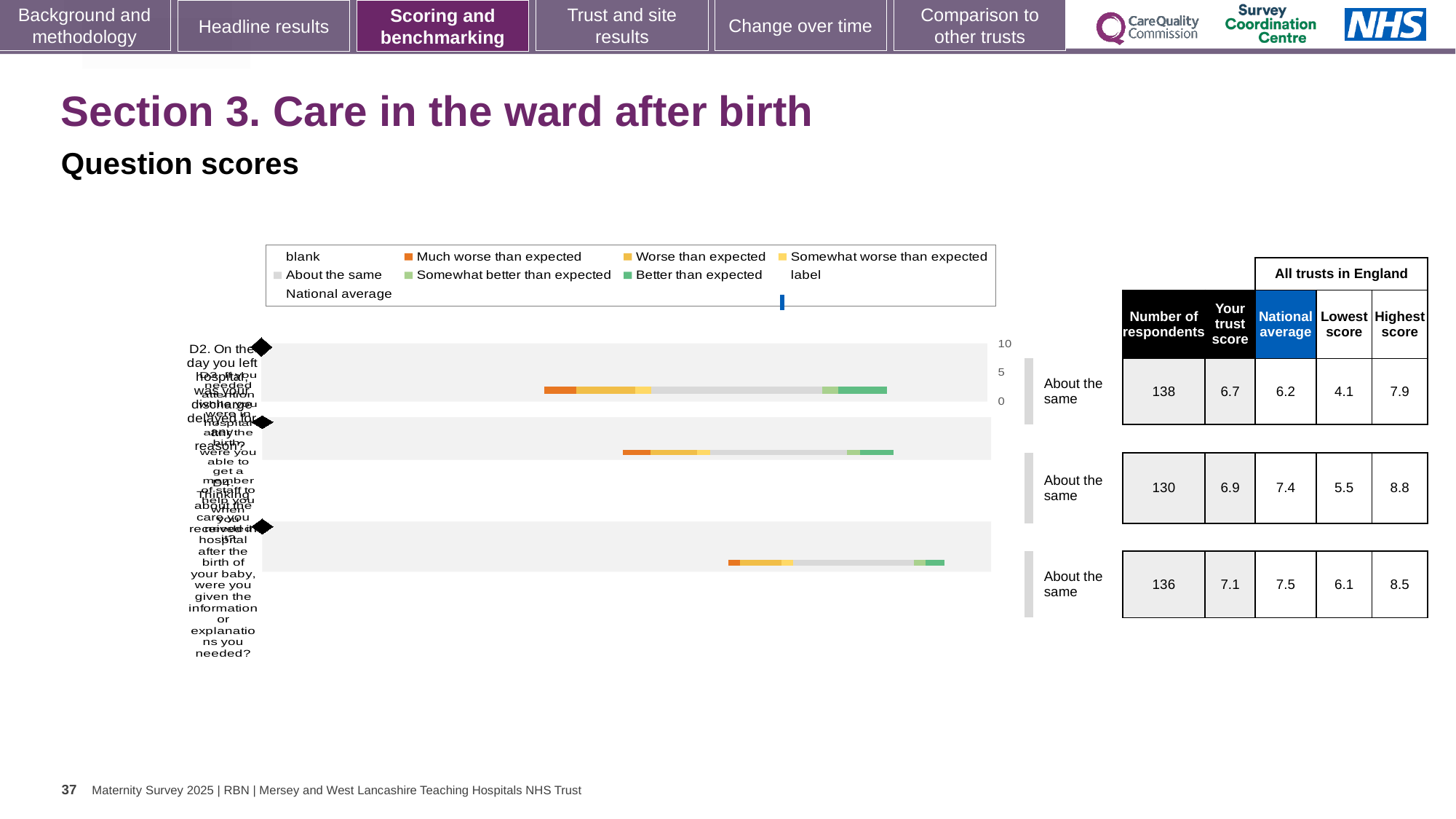
What benchmark label is shown next to each of the three bars? About the same What kind of chart is shown on the slide? bar chart For the second (middle) row, which is larger: 'Your trust score' or the national average? National average In the table, what is the national average for the third (bottom) row? 7.5 In the table, what is the highest score for the second (middle) row? 8.8 Which row has the highest 'Your trust score' in the table? the third (bottom) row, 7.1 In the table, what is 'Your trust score' for the second (middle) row? 6.9 How many bars (question rows) are plotted in the chart? 3 In the table, what is the lowest score for the first (top) row? 4.1 For the first (top) row, which is larger: 'Your trust score' or the national average? Your trust score What is the difference between the highest score and the lowest score for the first (top) row? 3.8 In the table, what is the number of respondents for the first (top) row? 138